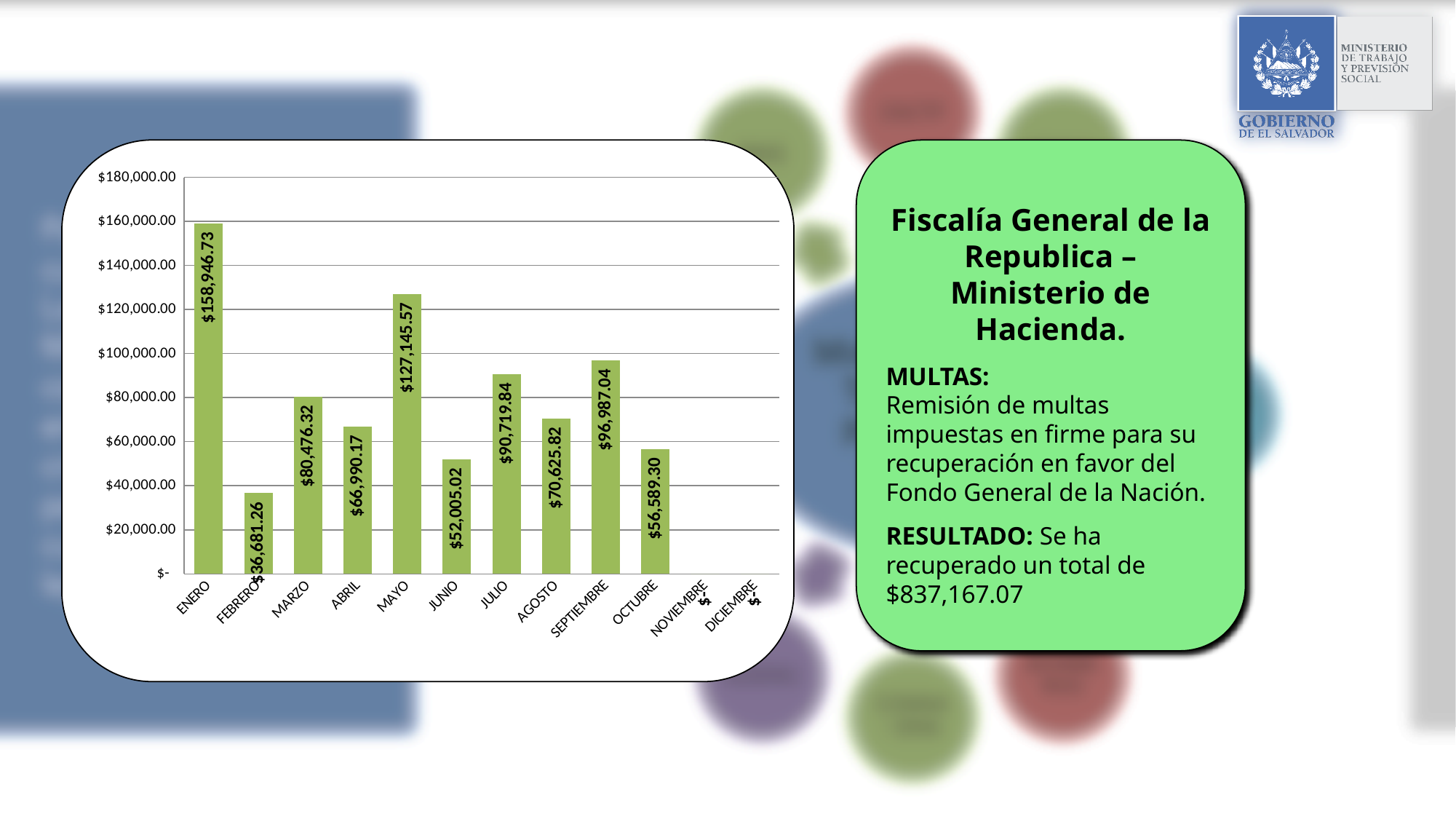
How many months are shown on the x axis? 12 What is the difference between the values for ENERO and MAYO? $31,801.16 What is the value for FEBRERO? $36,681.26 What is the difference between the values for SEPTIEMBRE and JULIO? $6,267.20 Which is larger, the value for MARZO or the value for AGOSTO? MARZO What is the value for MAYO? $127,145.57 What is the value for ENERO? $158,946.73 What is the value for SEPTIEMBRE? $96,987.04 What kind of chart is shown on the slide? bar chart Among the months from ENERO to OCTUBRE, which has the lowest value? FEBRERO Is the value for JUNIO greater or less than $60,000.00? less Which month has the highest value? ENERO